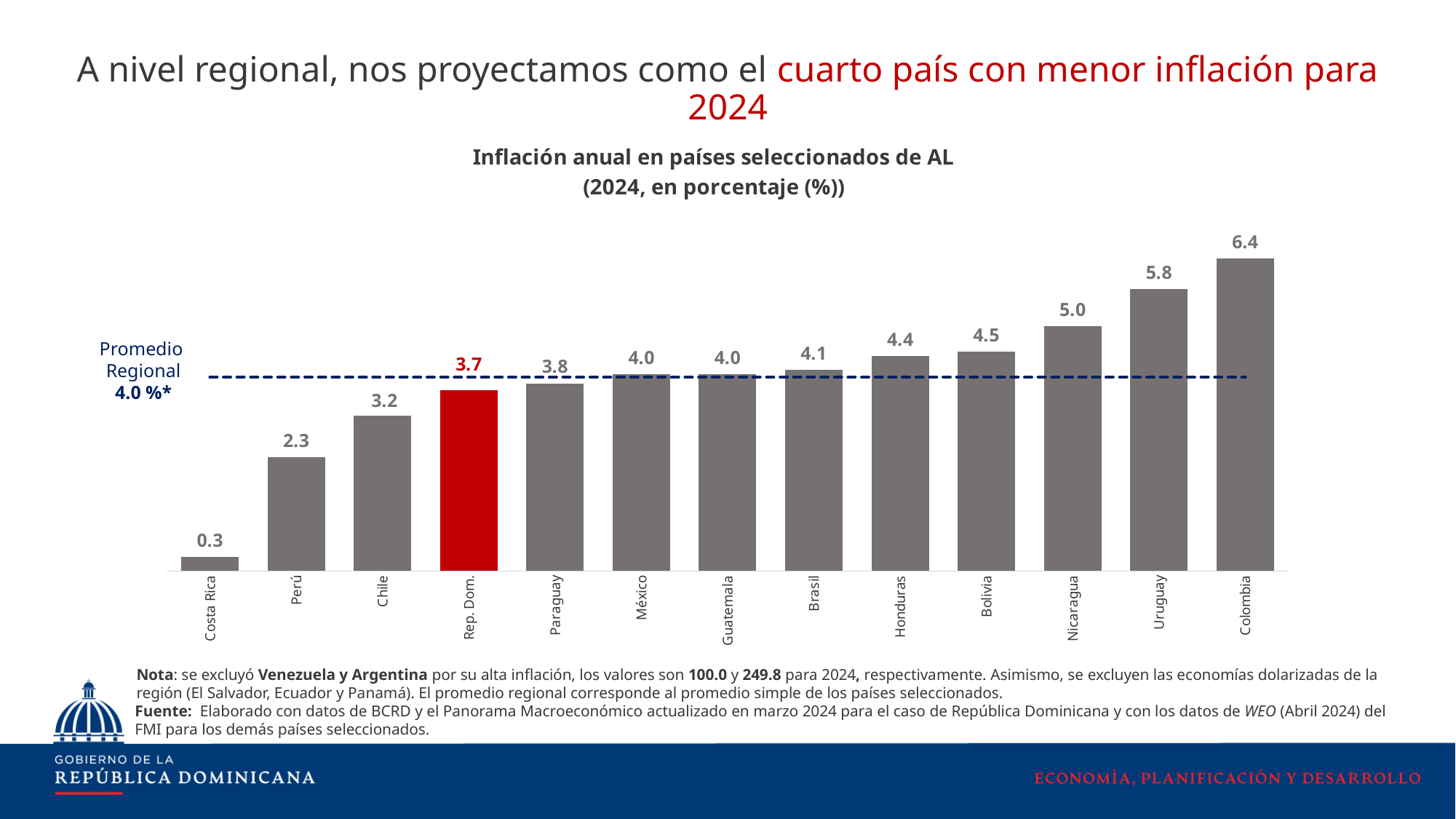
What is the inflation value shown for Costa Rica? 0.3 Which country has the lowest inflation value in the chart? Costa Rica What kind of chart is shown on the slide? Bar chart Do the inflation values rise or fall from left to right across the chart? Rise What is the difference between the inflation values for Rep. Dom. and Chile? 0.5 What is the projected 2024 inflation value for Rep. Dom.? 3.7 What value is given for the 'Promedio Regional' dashed line? 4.0 %* What is the difference between the inflation values for Uruguay and Nicaragua? 0.8 How many countries are shown in the chart? 13 What is the inflation value shown for Colombia? 6.4 Which country has the highest inflation value in the chart? Colombia Which has a higher inflation value, Honduras or Bolivia? Bolivia